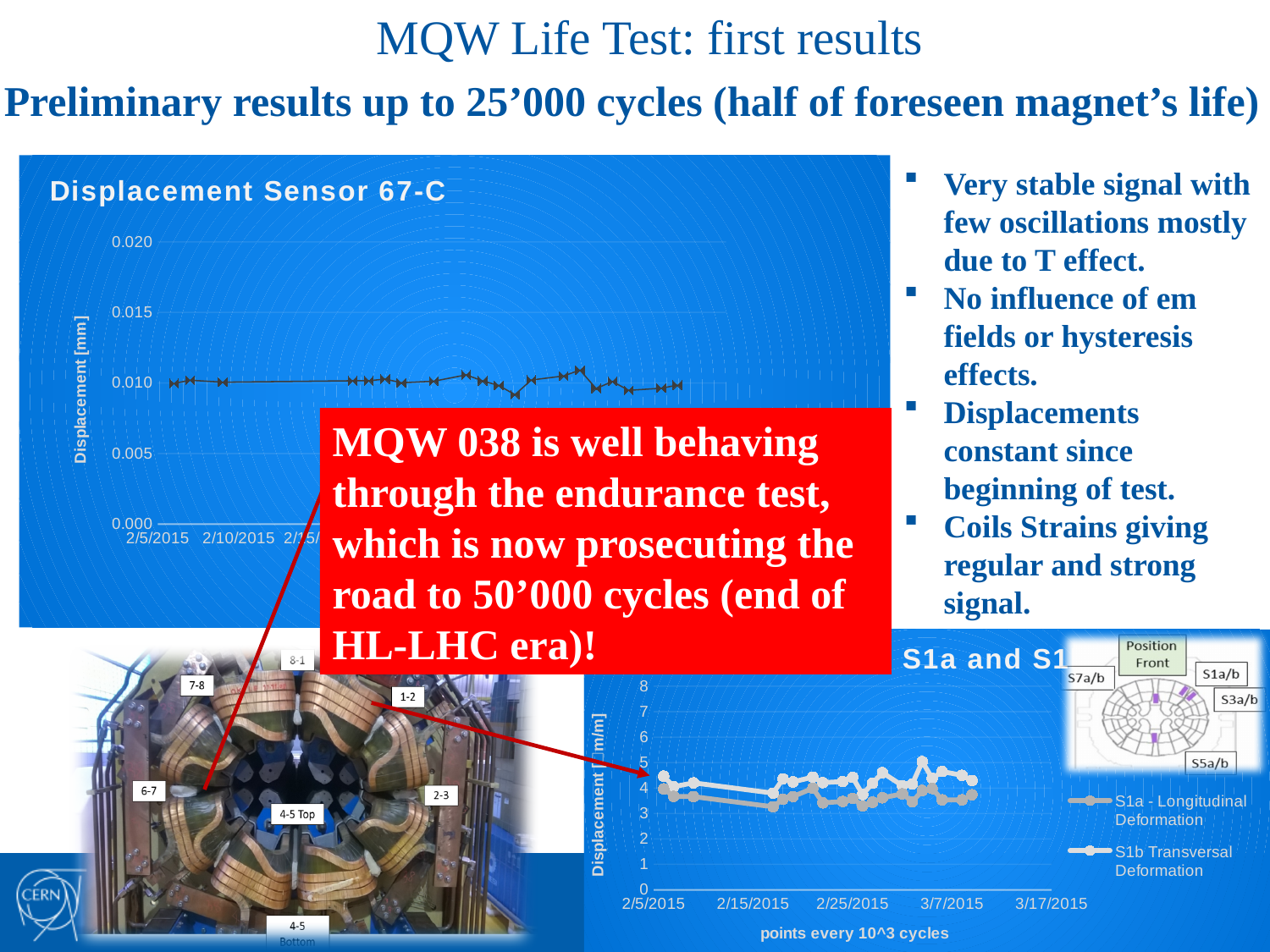
In the 'Displacement Sensor 67-C' chart, are the plotted values greater or less than 0.005? greater How many date labels are shown on the x-axis of the bottom-right chart (S1a and S1b)? 5 In the 'Displacement Sensor 67-C' chart, what is the first date shown on the x-axis? 2/5/2015 What type of chart is the 'Displacement Sensor 67-C' chart? line chart What type of chart is the bottom-right chart showing S1a and S1b? line chart In the bottom-right chart (S1a and S1b), are the values of the S1b Transversal Deformation series greater or less than 6? less In the 'Displacement Sensor 67-C' chart, are the plotted values greater or less than 0.015? less In the 'Displacement Sensor 67-C' chart, do the values rise, fall, or stay roughly constant along the x axis? roughly constant In the 'Displacement Sensor 67-C' chart, what is the label of the y-axis? Displacement [mm] How many series does the legend of the bottom-right chart (S1a and S1b) list? 2 In the bottom-right chart (S1a and S1b), which series lies higher over most of the period, S1a - Longitudinal Deformation or S1b Transversal Deformation? S1b Transversal Deformation